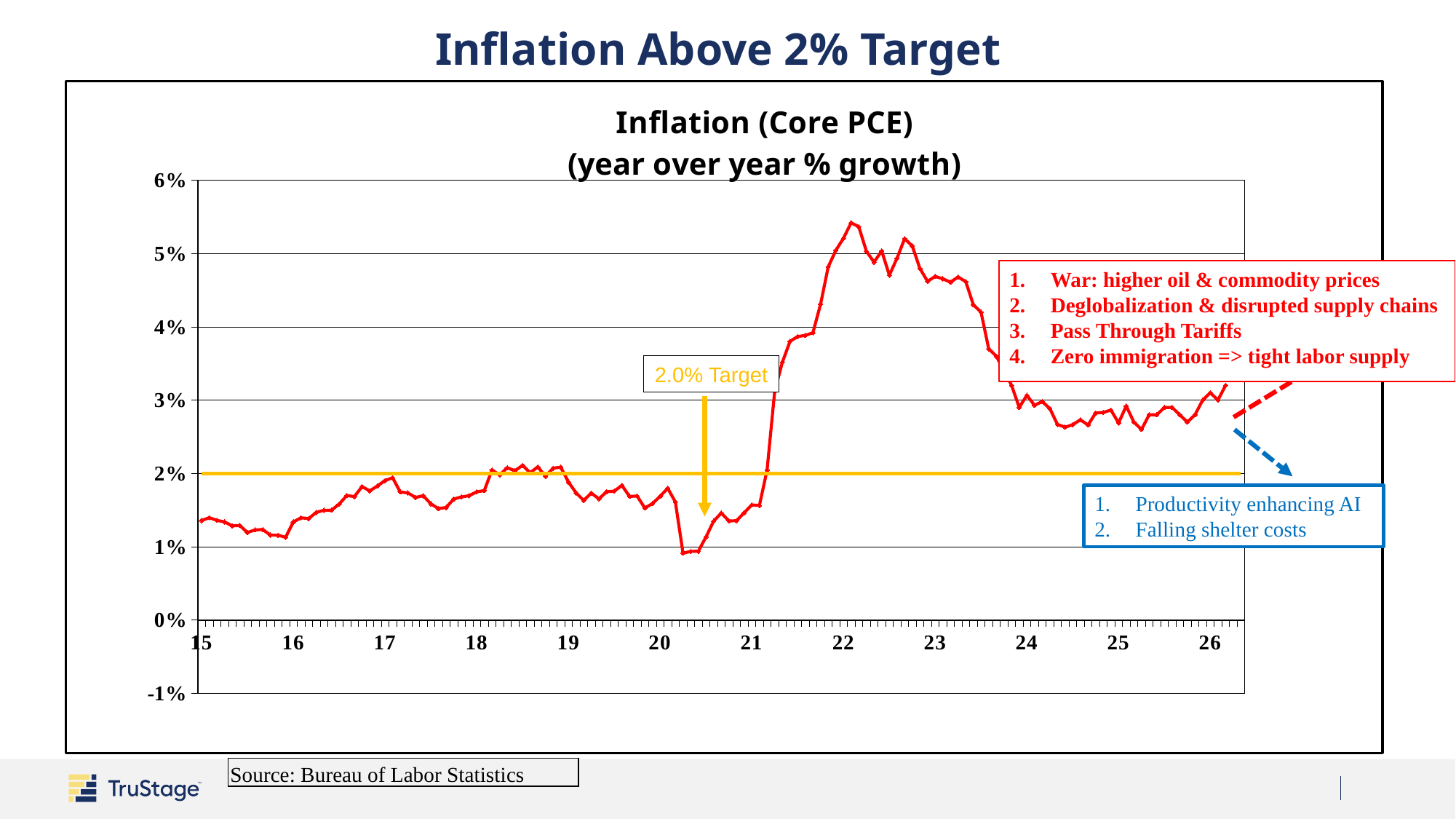
What is the source cited for the chart data? Bureau of Labor Statistics Does Core PCE inflation rise or fall between the start of 2021 and the start of 2022? rise What is the title of the chart? Inflation (Core PCE) (year over year % growth) Which is larger, Core PCE inflation at the start of 2022 or at the start of 2019? 2022 In which year does Core PCE inflation reach its highest point on the chart? 2022 Is the value of Core PCE inflation at the start of 2015 greater or less than 2%? less Is the peak value of Core PCE inflation in 2022 greater or less than 5%? greater Is the value of Core PCE inflation at the start of 2024 greater or less than 2%? greater Does Core PCE inflation rise or fall between 2022 and 2024? fall What inflation target level is marked by the horizontal yellow line? 2.0% What kind of chart is shown on the slide? line chart